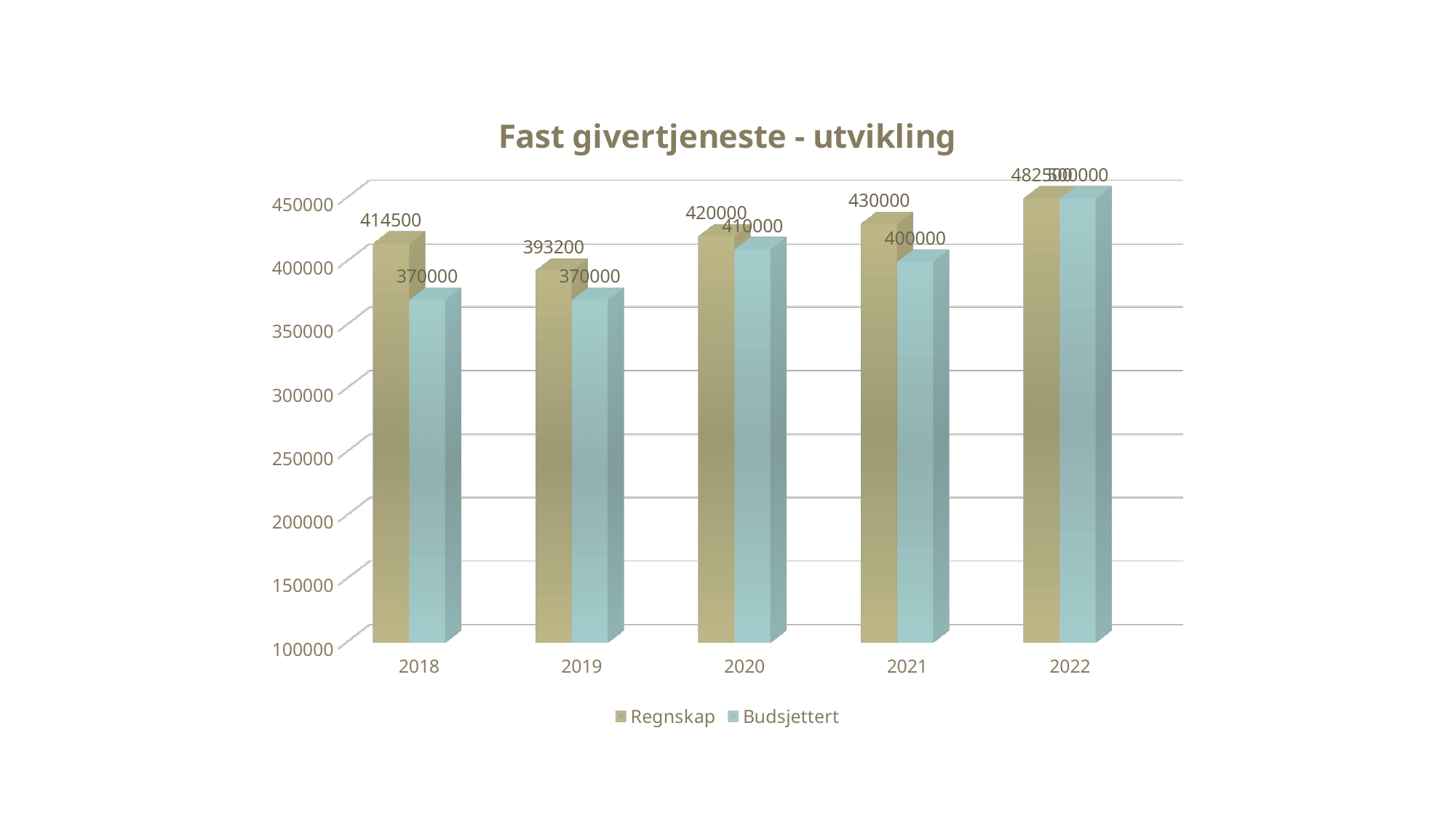
Which year has the lowest Regnskap value? 2019 What is the difference between the Regnskap and Budsjettert values for 2021? 30000 What is the Budsjettert value for 2021? 400000 What is the Budsjettert value for 2019? 370000 How many years are shown on the x axis? 5 Is the Budsjettert value for 2018 greater or less than 400000? less What kind of chart is shown on the slide? bar chart What is the Regnskap value for 2020? 420000 Which is larger for 2019, Regnskap or Budsjettert? Regnskap How many series does the legend list? 2 What is the difference between the Regnskap and Budsjettert values for 2018? 44500 What is the Regnskap value for 2018? 414500